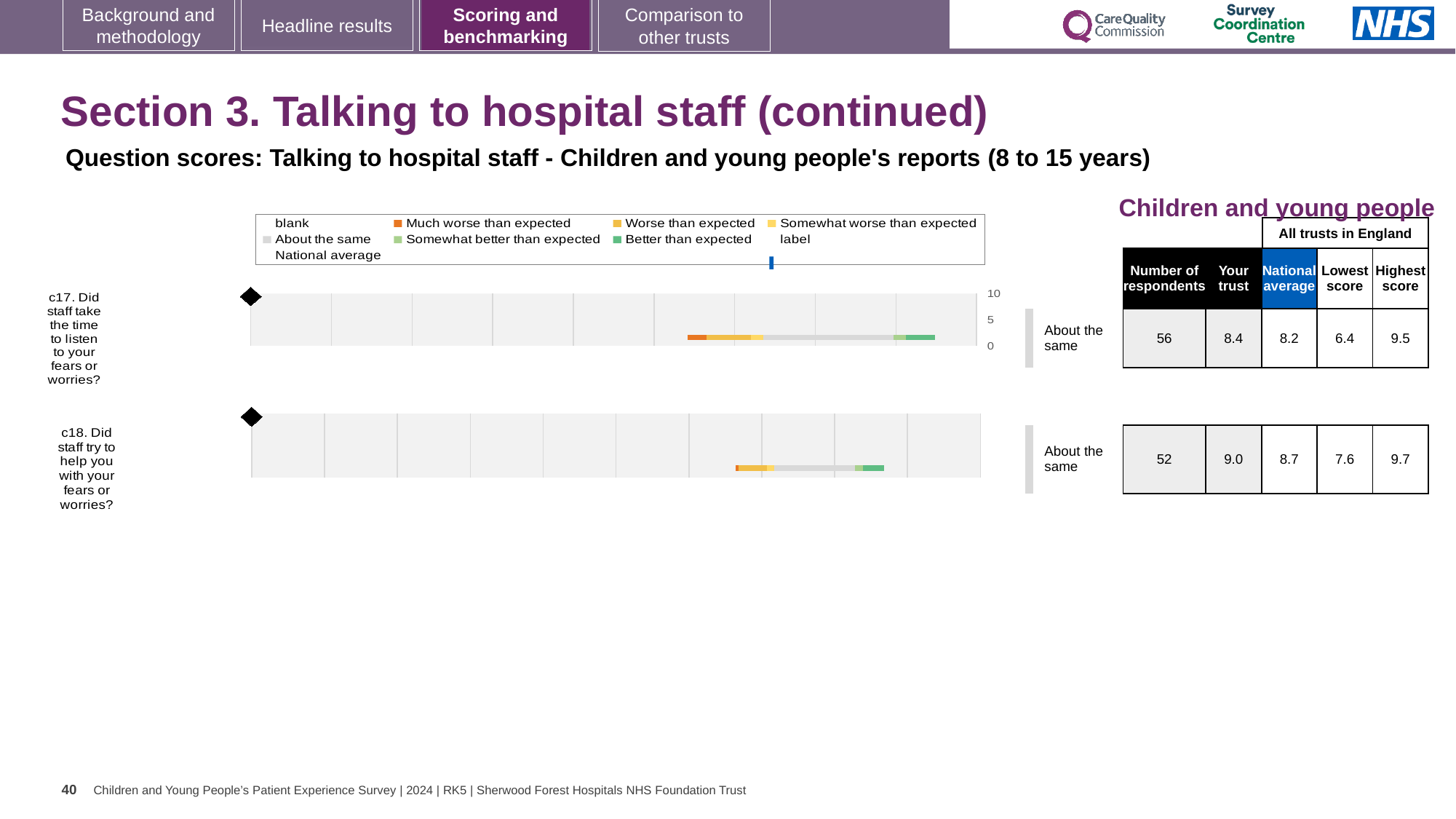
For the c17 chart (Did staff take the time to listen to your fears or worries?), what is the 'Your trust' score? 8.4 What kind of chart is used to show the benchmark bands for questions c17 and c18? bar chart For the c17 chart, what is the highest score among all trusts in England? 9.5 How many questions are charted on this slide? 2 For the c17 chart, which benchmark category is the trust placed in? About the same For the c18 chart, what is the lowest score among all trusts in England? 7.6 For the c18 chart, what is the difference between the 'Your trust' score and the national average? 0.3 Which question has the higher 'Your trust' score, c17 or c18? c18 For the c17 chart, how many respondents are there? 56 For the c18 chart (Did staff try to help you with your fears or worries?), what is the 'Your trust' score? 9.0 For the c18 chart, what is the national average score? 8.7 For the c17 chart, what is the national average score? 8.2